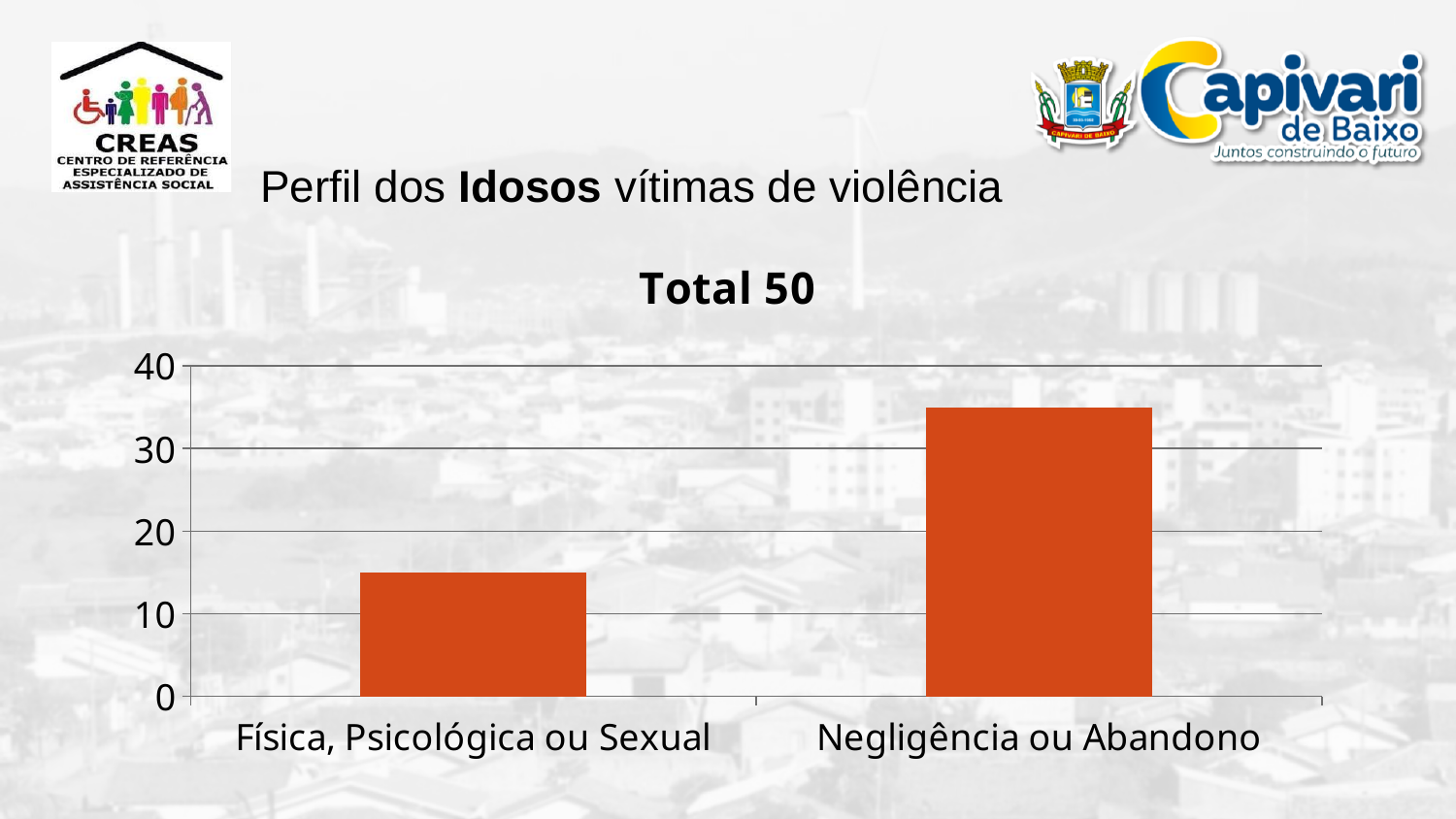
Do the bar values rise or fall from left to right along the x axis? rise Is the value for Física, Psicológica ou Sexual greater or less than 10? greater Is the value for Negligência ou Abandono greater or less than 30? greater Which category has the highest bar in the chart? Negligência ou Abandono Is the value for Física, Psicológica ou Sexual greater or less than 20? less Which is larger, the value for Física, Psicológica ou Sexual or the value for Negligência ou Abandono? Negligência ou Abandono What is the highest value shown on the y axis of the chart? 40 Which category has the lowest bar in the chart? Física, Psicológica ou Sexual What is the title of the chart? Total 50 What kind of chart is shown on the slide? bar chart How many categories are shown on the x axis of the chart? 2